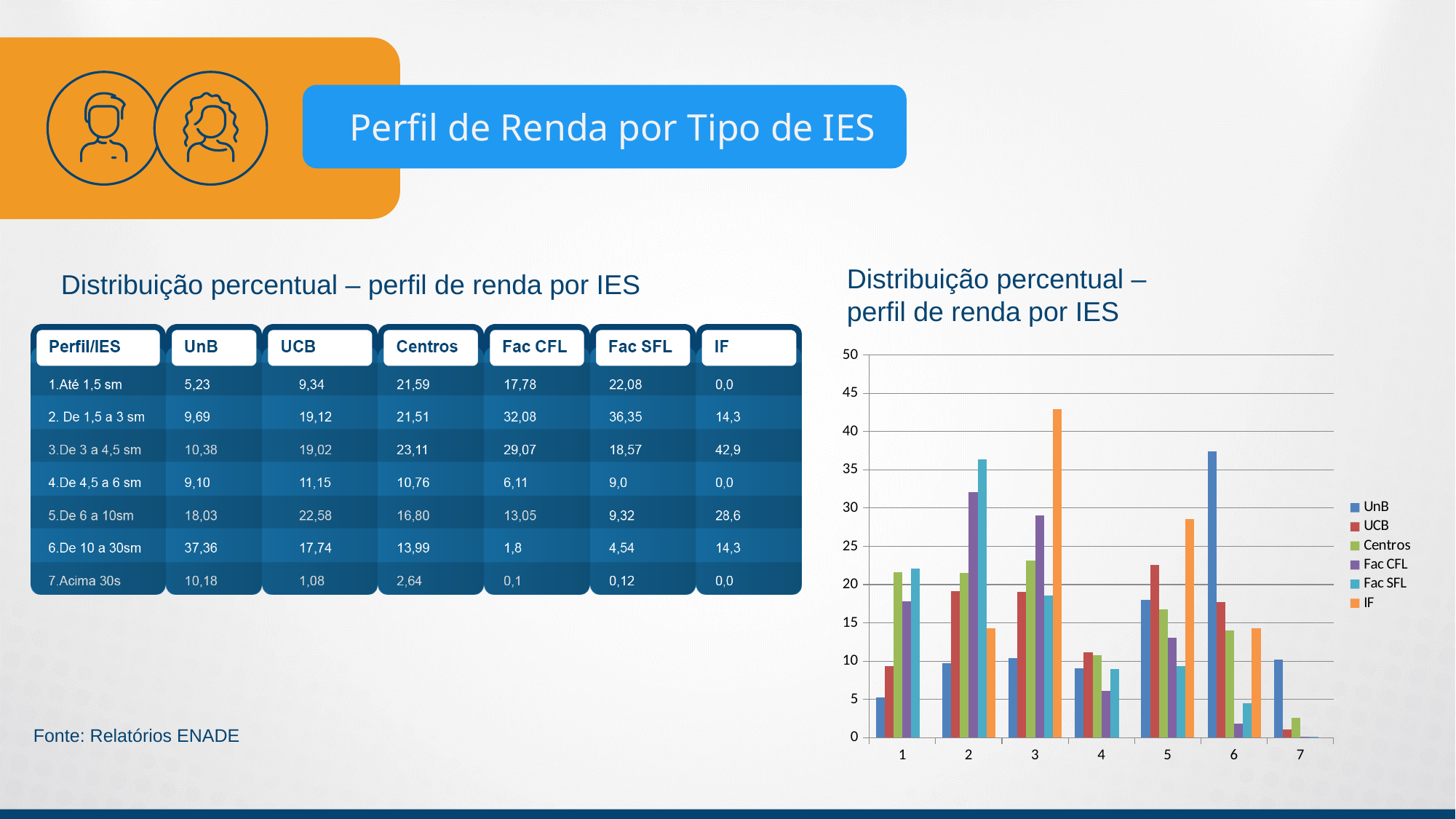
In the chart, is the value for UnB at category 6 greater or less than 35? greater What colour represents the IF series in the chart? orange In the chart, is the value for IF at category 3 greater or less than 40? greater What kind of chart is shown on the slide? bar chart In the chart, which series has the lowest bar at category 1? IF In the chart, is the value for Fac SFL at category 1 greater or less than 20? greater How many categories are shown on the x axis of the chart? 7 In the chart, at which category does the UnB series reach its highest bar? 6 How many series does the chart legend list? 6 In the chart, at category 2, which is larger: Fac SFL or Fac CFL? Fac SFL In the chart, which series has the tallest bar at category 3? IF